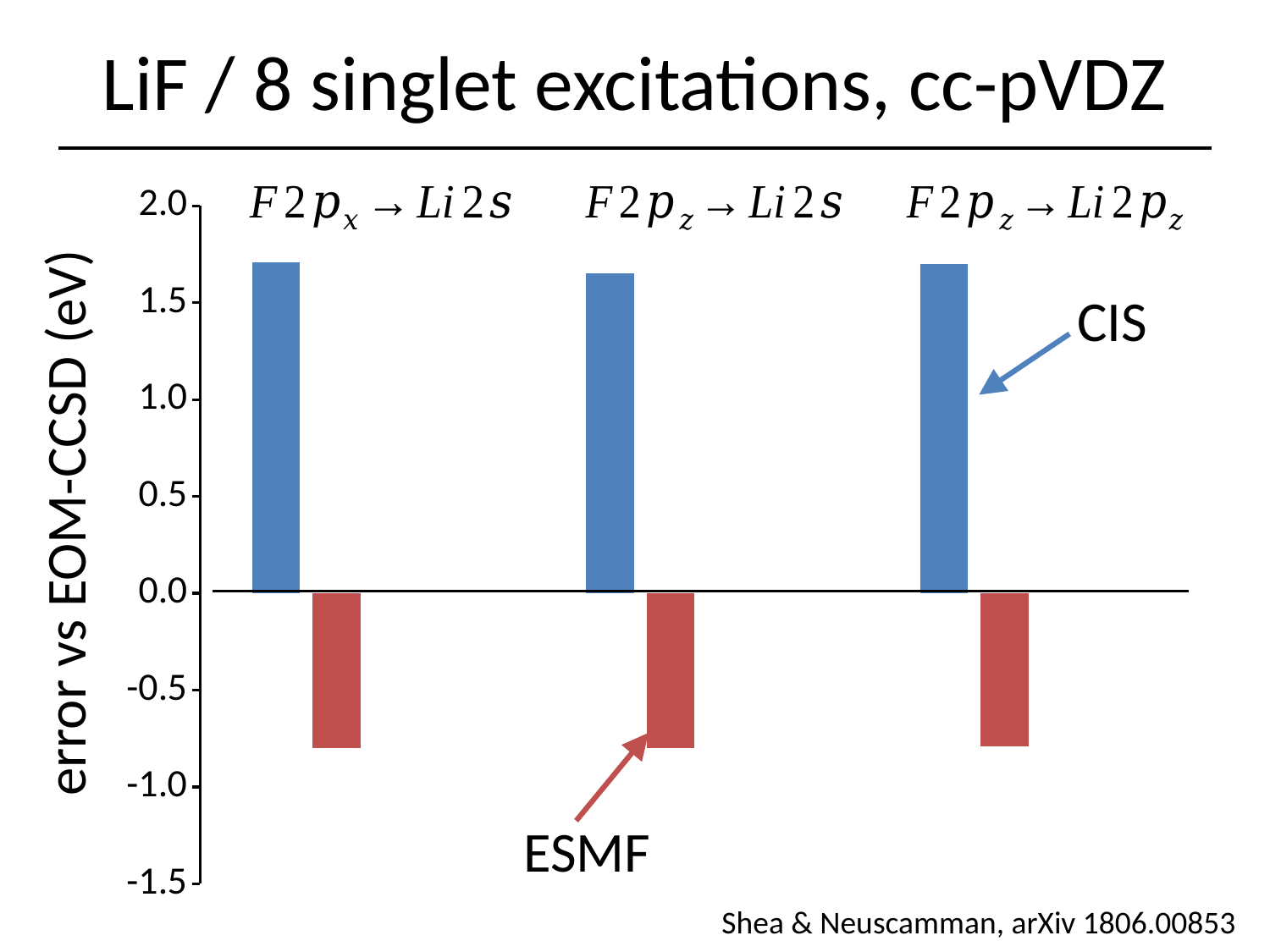
Is the CIS error for the F 2pz → Li 2pz excitation greater or less than 2.0 eV? less Is the ESMF error for the F 2pz → Li 2s excitation greater or less than -0.5 eV? less For the F 2px → Li 2s excitation, which method has the larger error value, CIS or ESMF? CIS What is the label of the y axis? error vs EOM-CCSD (eV) Is the ESMF error for the F 2pz → Li 2pz excitation greater or less than -1.0 eV? greater Which method's bars are all negative in the chart? ESMF How many data series (methods) are plotted in the chart? 2 How many excitation categories are shown along the x axis? 3 What kind of chart is shown on the slide? bar chart